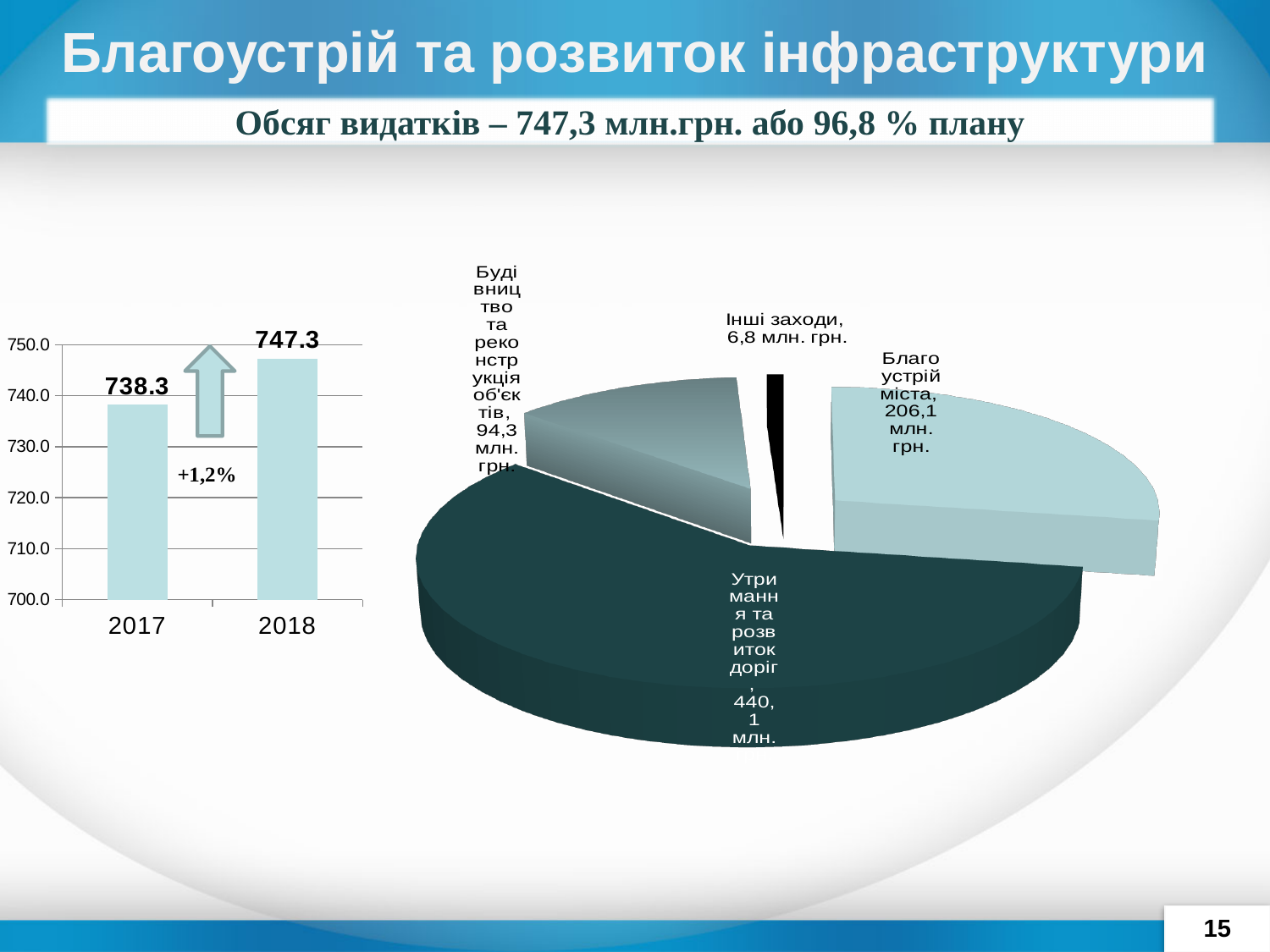
In the pie chart on the right, which category has the smallest slice? Інші заходи In the bar chart on the left, do the values rise or fall from 2017 to 2018? rise In the pie chart on the right, which category has the largest slice? Утримання та розвиток доріг In the bar chart on the left, what is the value for 2018? 747.3 In the bar chart on the left, what is the difference between the 2018 and 2017 values? 9.0 In the bar chart on the left, which year has the larger value, 2017 or 2018? 2018 In the bar chart on the left, how many categories are shown on the x axis? 2 In the pie chart on the right, what is the value for Благоустрій міста? 206,1 млн. грн. What kind of chart is the chart on the right? pie chart In the pie chart on the right, how many slices are there? 4 What kind of chart is the chart on the left? bar chart In the bar chart on the left, what is the value for 2017? 738.3